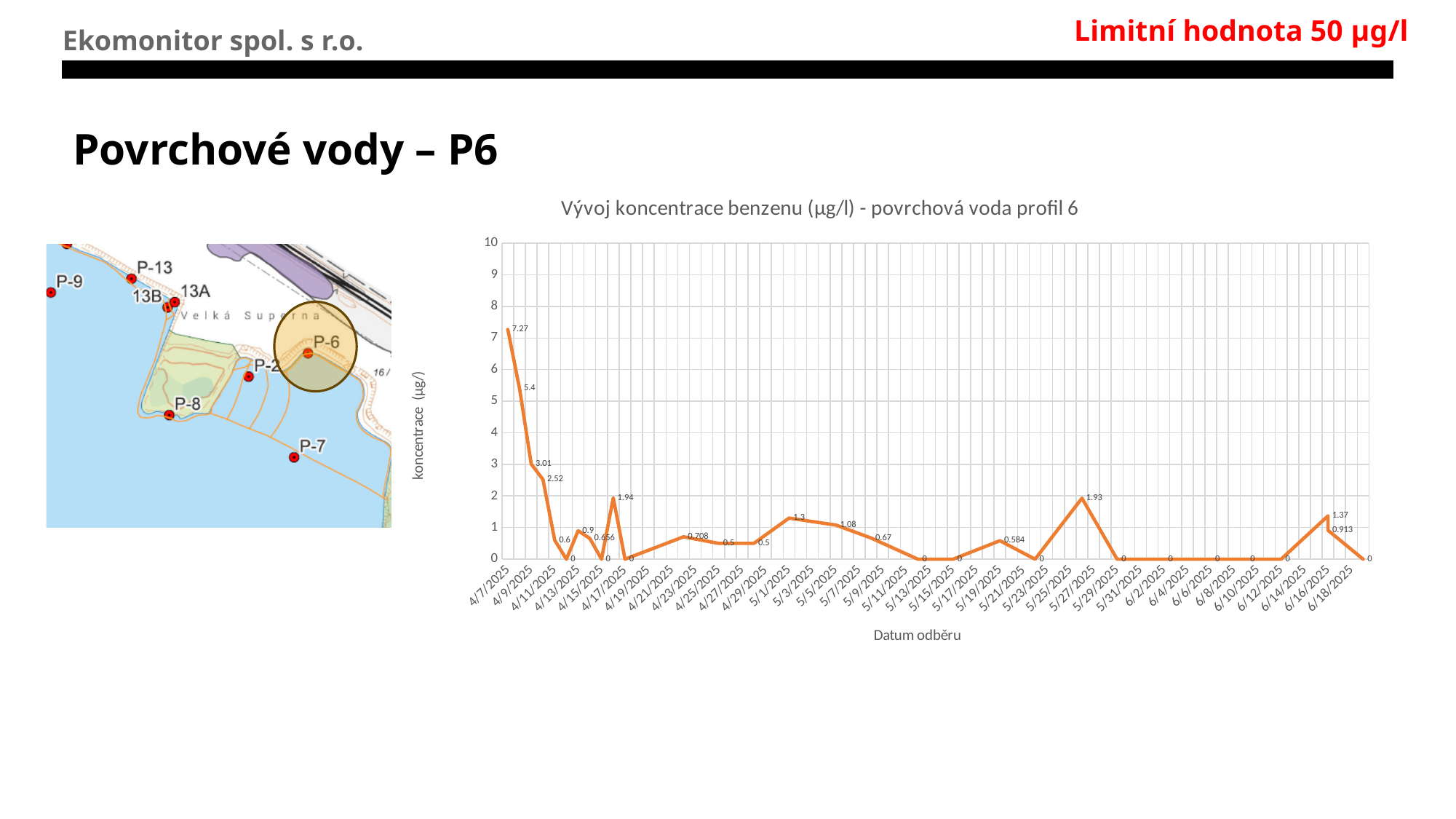
Is the concentration on 4/7/2025 greater or less than 5? greater What type of chart is shown on the slide? line chart What is the benzene concentration on 4/7/2025? 7.27 On which date is the benzene concentration highest? 4/7/2025 Does the benzene concentration generally rise or fall from the start to the end of the period shown? fall What is the benzene concentration on 5/19/2025? 0.584 What is the title of the chart? Vývoj koncentrace benzenu (µg/l) - povrchová voda profil 6 What is the benzene concentration on 5/1/2025? 1.3